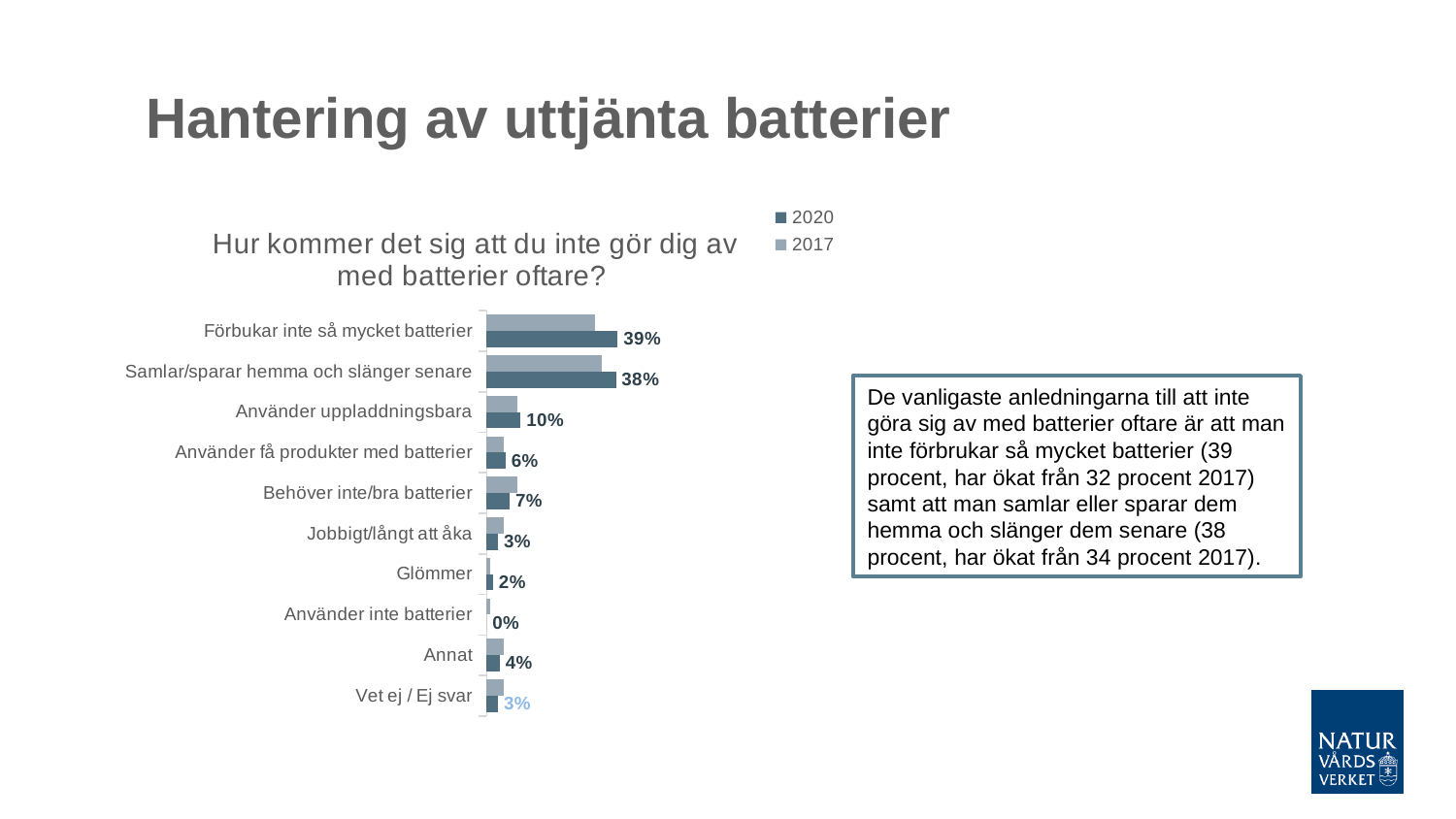
What type of chart is shown on the slide? bar chart How many categories are shown in the chart? 10 For 'Använder uppladdningsbara', which series has the larger value, 2020 or 2017? 2020 What is the 2020 value for 'Använder inte batterier'? 0% What is the title of the chart? Hur kommer det sig att du inte gör dig av med batterier oftare? Which category has the highest 2020 value? Förbukar inte så mycket batterier What is the 2020 value for 'Förbukar inte så mycket batterier'? 39% What is the 2020 value for 'Använder uppladdningsbara'? 10% How many series does the legend list? 2 What is the difference between the 2020 values for 'Använder uppladdningsbara' and 'Behöver inte/bra batterier'? 3% What is the 2020 value for 'Samlar/sparar hemma och slänger senare'? 38% Which category has the lowest 2020 value? Använder inte batterier